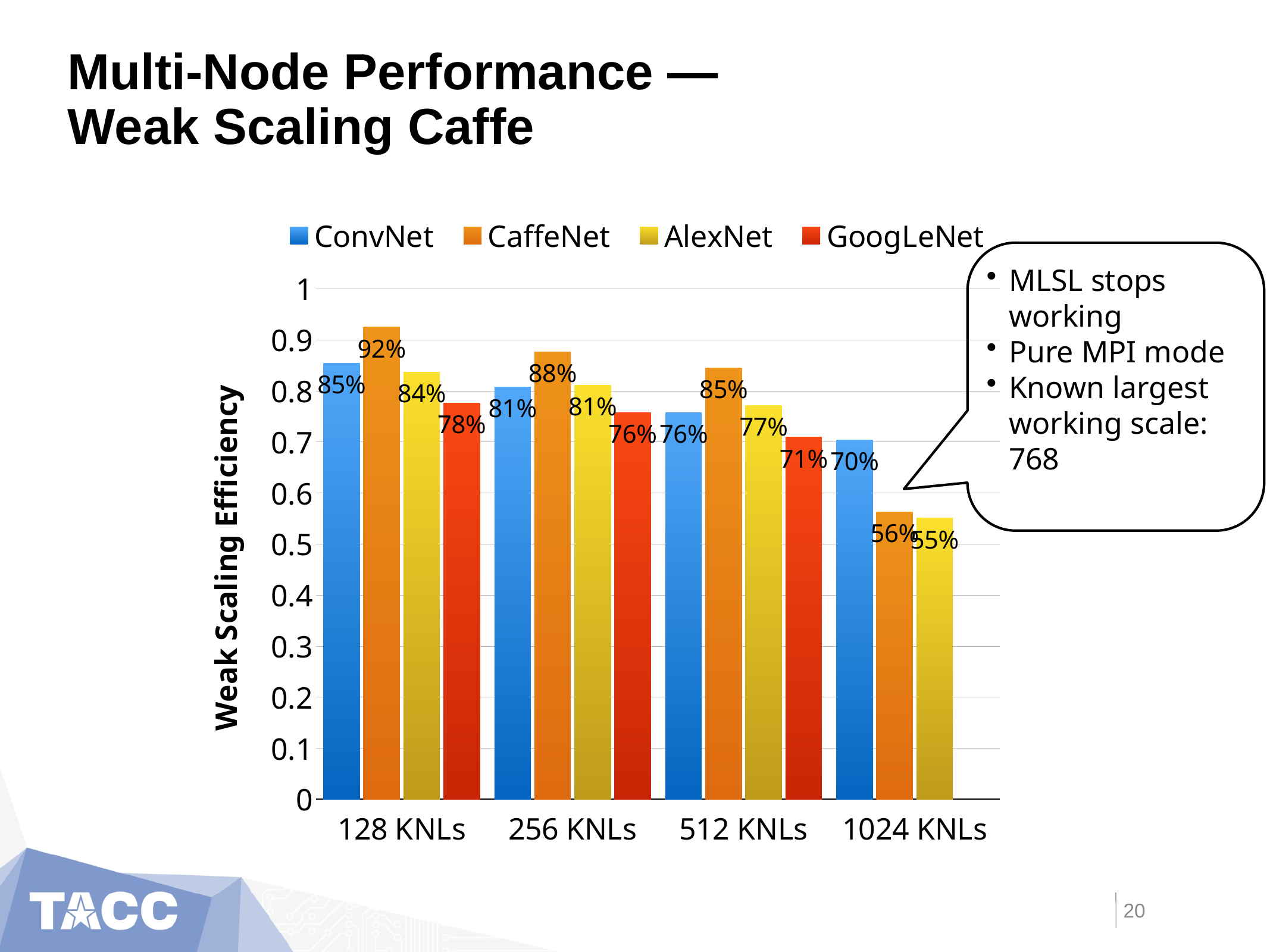
How many node-count categories are shown on the x axis? 4 Does CaffeNet's weak scaling efficiency rise or fall as the number of KNLs increases from 128 to 1024? Fall Which network has the lowest weak scaling efficiency at 1024 KNLs? AlexNet How many series does the legend list? 4 What is the weak scaling efficiency of AlexNet at 256 KNLs? 81% What is the weak scaling efficiency of GoogLeNet at 512 KNLs? 71% What is the weak scaling efficiency of CaffeNet at 128 KNLs? 92% Which is larger: ConvNet's efficiency at 1024 KNLs or CaffeNet's efficiency at 1024 KNLs? ConvNet's efficiency at 1024 KNLs Which network has the highest weak scaling efficiency at 512 KNLs? CaffeNet What is the weak scaling efficiency of ConvNet at 1024 KNLs? 70% What is the difference between CaffeNet's and GoogLeNet's weak scaling efficiency at 128 KNLs? 14% What kind of chart is shown on the slide? Bar chart